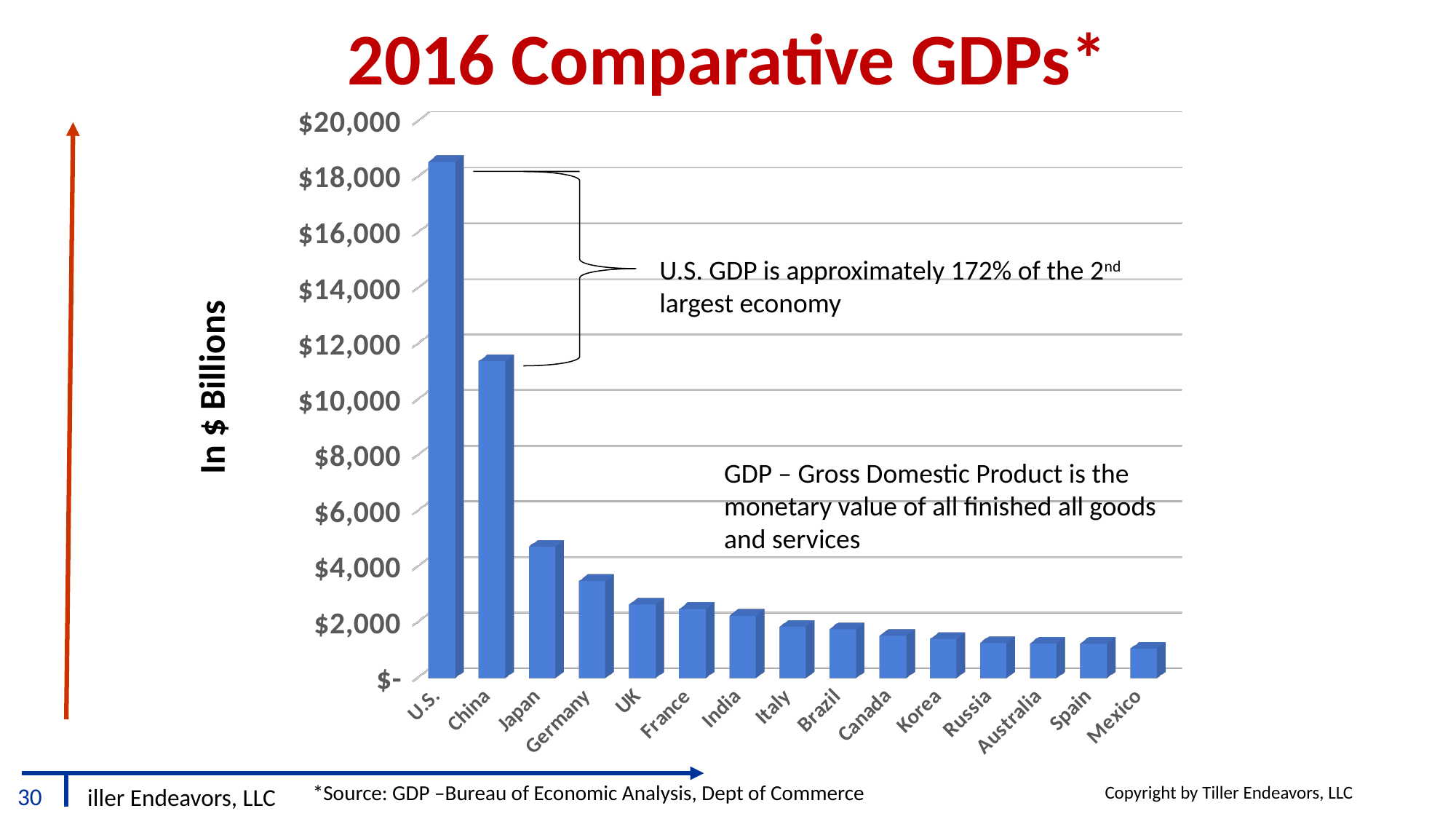
What kind of chart is shown on the slide? bar chart Is the value for Germany greater or less than $4,000? less What is the label on the vertical axis of the chart? In $ Billions Which country has the lowest GDP in the chart? Mexico Which country has the highest GDP in the chart? U.S. Which has a larger GDP, China or the U.S.? U.S. Do the bar values rise or fall moving from left to right along the x axis? fall How many countries are shown on the x axis of the chart? 15 Which has a larger GDP, Japan or Germany? Japan Is the value for the U.S. greater or less than $18,000? greater Is the value for China greater or less than $10,000? greater